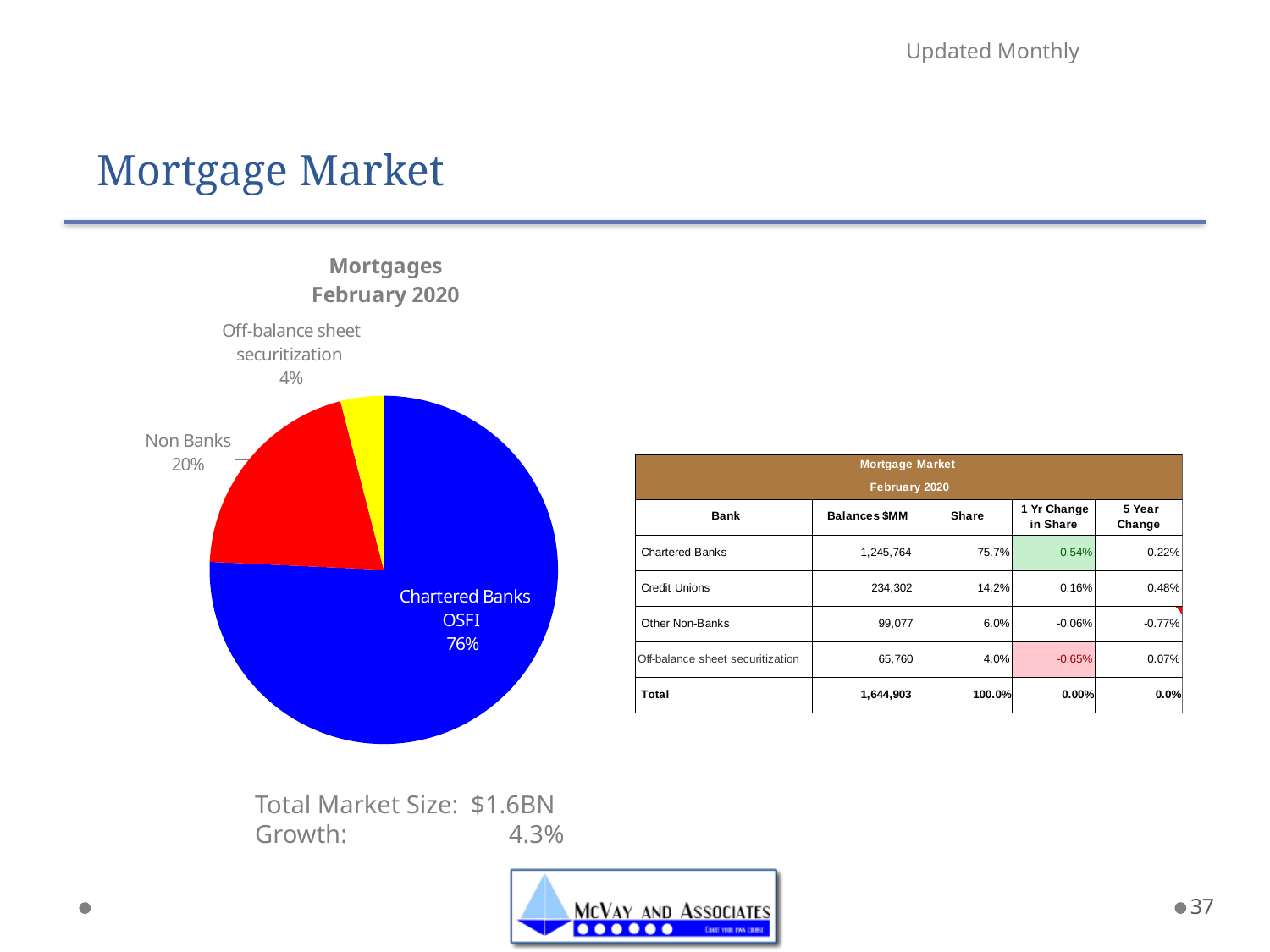
What share of the pie does Non Banks hold? 20% Which slice of the pie chart is the largest? Chartered Banks OSFI How many slices does the pie chart have? 3 What kind of chart is shown on the slide? pie chart What is the difference in percentage points between the Non Banks slice and the Off-balance sheet securitization slice? 16 What is the difference in percentage points between the Chartered Banks OSFI slice and the Non Banks slice? 56 What colour is the Chartered Banks OSFI slice in the pie chart? blue What share of the pie does Off-balance sheet securitization hold? 4% What share of the pie does Chartered Banks OSFI hold? 76% Which slice of the pie chart is the smallest? Off-balance sheet securitization Which is larger in the pie chart, Non Banks or Off-balance sheet securitization? Non Banks What is the title of the pie chart? Mortgages February 2020